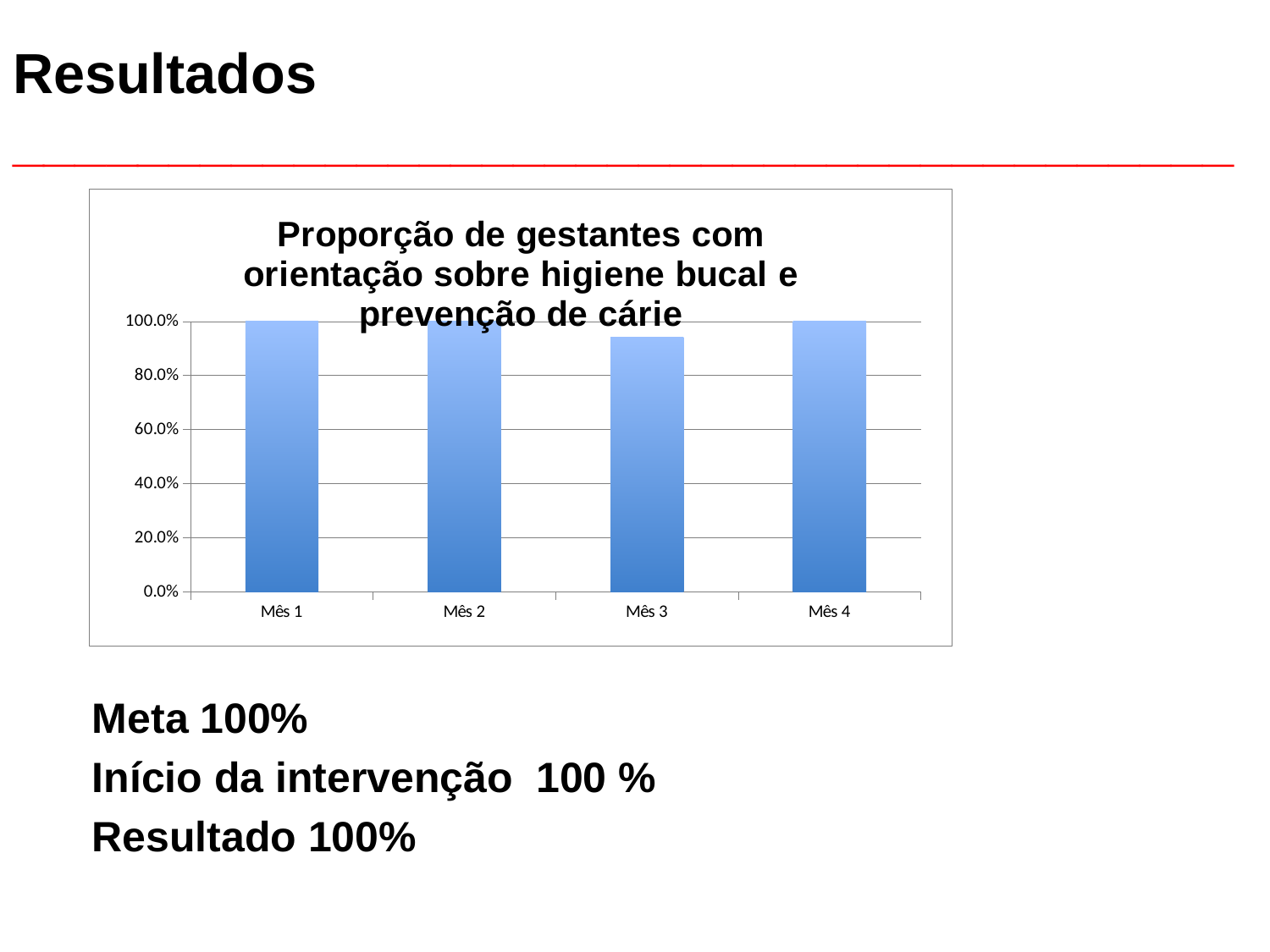
Which month has the lowest value in the chart? Mês 3 How many categories (months) are shown on the x axis of the chart? 4 Is the value for Mês 3 greater or less than 100.0%? less Is the value for Mês 3 greater or less than 80.0%? greater What is the highest tick value shown on the y axis of the chart? 100.0% What kind of chart is shown on the slide? bar chart What is the title of the chart? Proporção de gestantes com orientação sobre higiene bucal e prevenção de cárie What is the value for Mês 4 in the chart? 100.0% What is the value for Mês 1 in the chart? 100.0% Which is larger, the value for Mês 3 or the value for Mês 4? Mês 4 Which is larger, the value for Mês 1 or the value for Mês 3? Mês 1